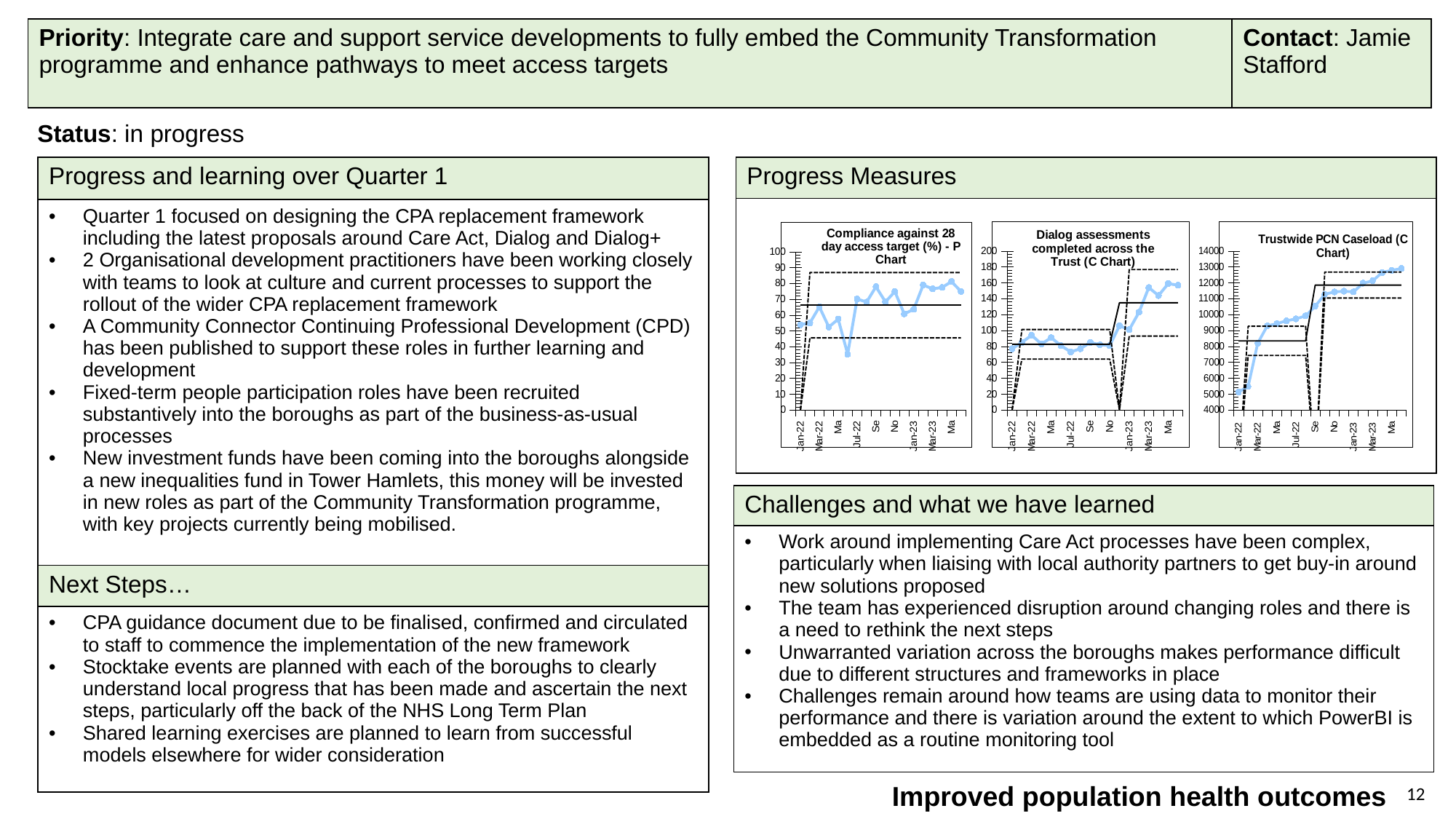
In the 'Dialog assessments completed across the Trust (C Chart)', do the plotted values generally rise or fall from Jan-22 to the latest month? rise In the 'Dialog assessments completed across the Trust (C Chart)', is the value for the latest plotted month greater or less than 140? greater In the 'Compliance against 28 day access target (%) - P Chart', is the lowest plotted value greater or less than 50? less In the 'Trustwide PCN Caseload (C Chart)', is the value for the latest plotted month greater or less than 12000? greater What is the title of the rightmost chart in the Progress Measures section? Trustwide PCN Caseload (C Chart) What is the title of the middle chart in the Progress Measures section? Dialog assessments completed across the Trust (C Chart) What kind of chart is the 'Compliance against 28 day access target (%) - P Chart'? line chart In the 'Trustwide PCN Caseload (C Chart)', do the plotted values generally rise or fall from Jan-22 to the latest month? rise How many charts are shown in the Progress Measures section of the slide? 3